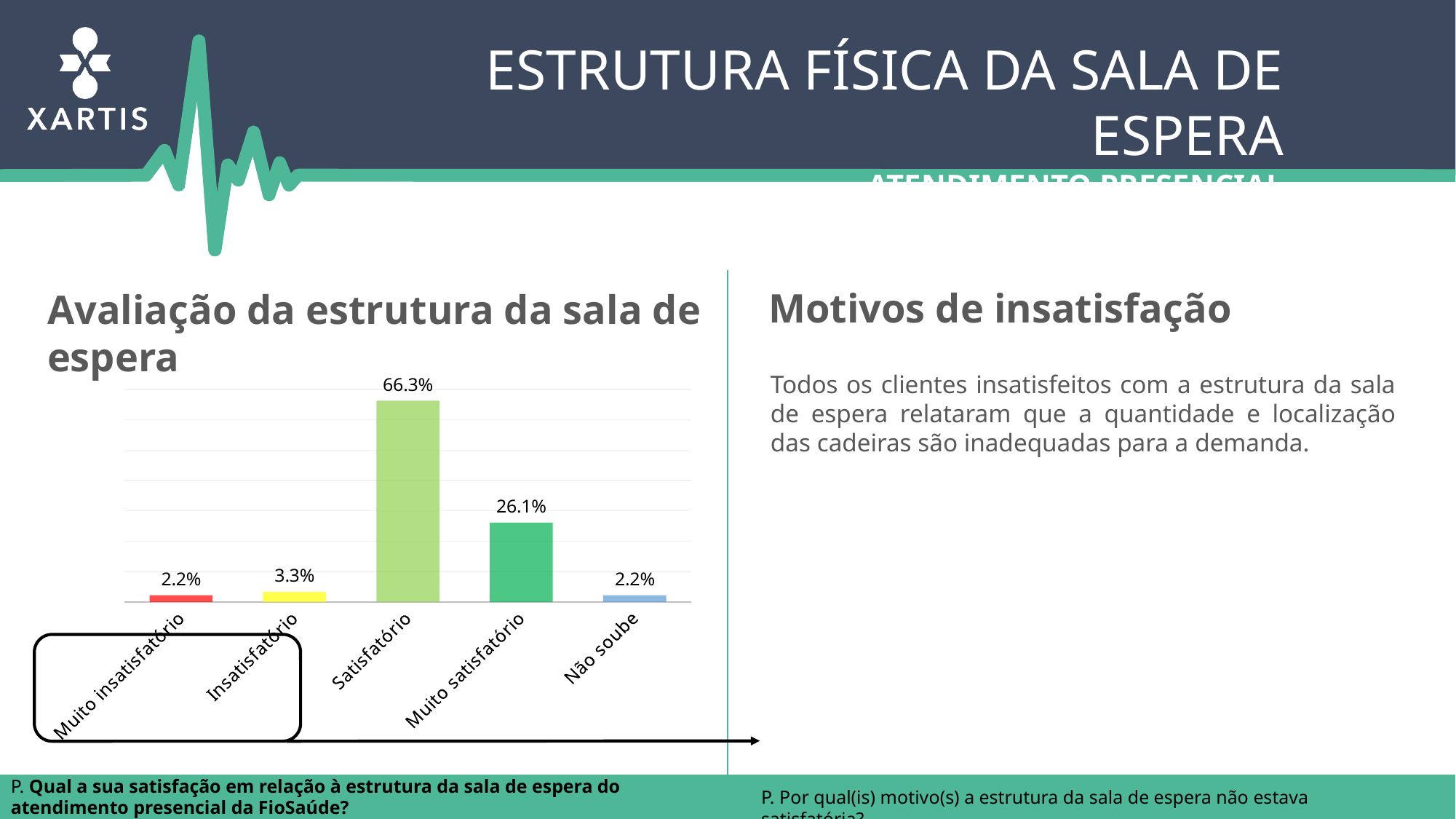
How many categories are shown in the chart? 5 What is the value for Insatisfatório? 3.3% Which is larger, the value for Insatisfatório or the value for Não soube? Insatisfatório Which category has the highest value? Satisfatório What is the difference between the values for Insatisfatório and Muito insatisfatório? 1.1% What is the title of the chart? Avaliação da estrutura da sala de espera What is the value for Muito satisfatório? 26.1% What is the value for Não soube? 2.2% What is the difference between the values for Satisfatório and Muito satisfatório? 40.2% What is the value for Muito insatisfatório? 2.2% What is the value for Satisfatório? 66.3% What kind of chart is shown on the slide? Bar chart